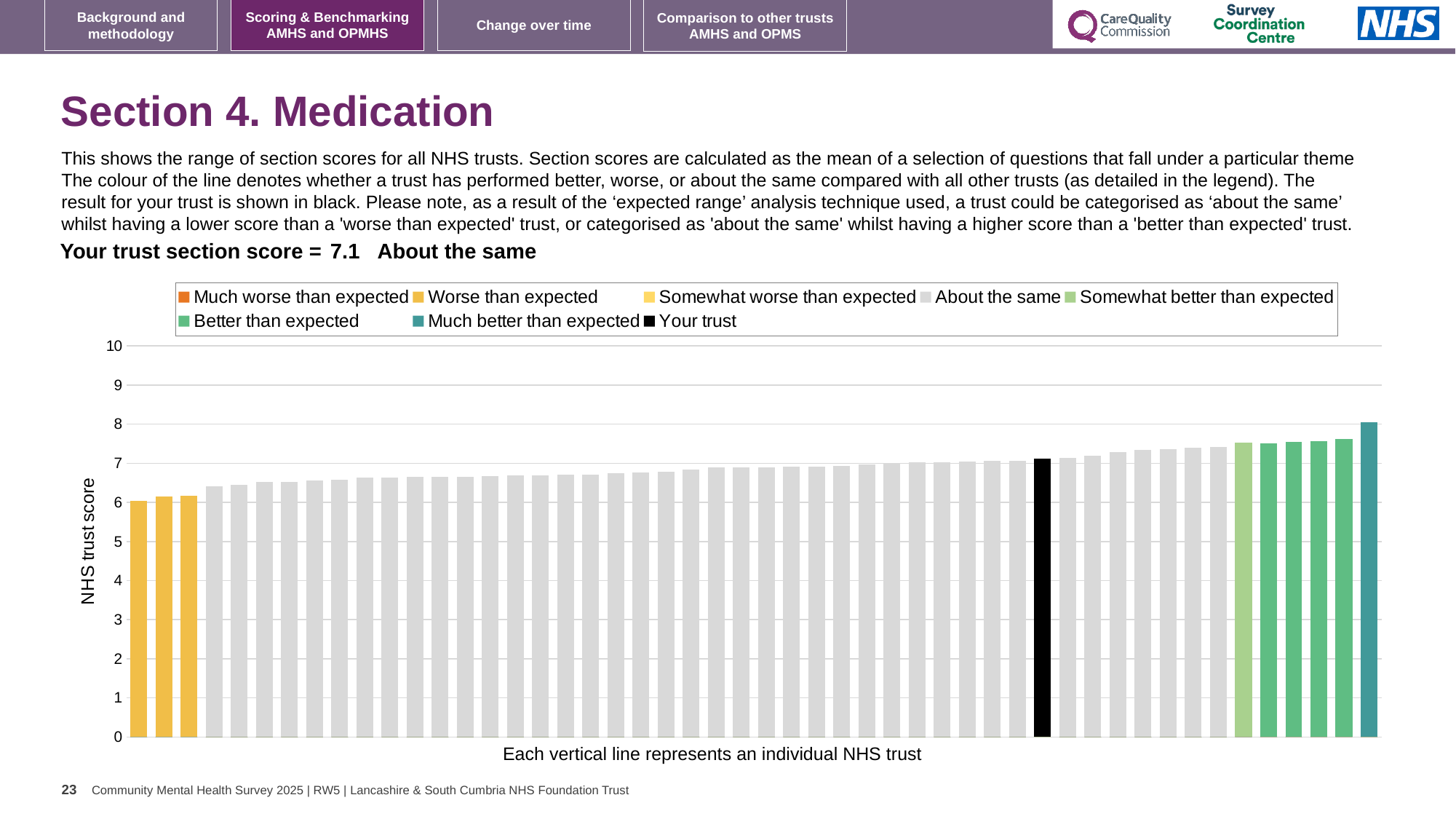
How many bars are coloured as 'Much better than expected' (teal)? 1 Which performance category is your trust placed in for Section 4. Medication? About the same How many entries does the chart legend list? 8 What is the section score for your trust shown on the slide? 7.1 Is the value of the black 'Your trust' bar greater or less than 5? greater What colour is the bar representing your trust? black Do the bar values rise or fall from left to right along the x axis? rise Is the value of the rightmost (highest) bar greater or less than 7? greater How many bars are coloured as 'Worse than expected' (yellow)? 3 What is the label on the vertical axis of the chart? NHS trust score Is the value of the leftmost (lowest) bar greater or less than 7? less What kind of chart is shown on the slide? bar chart